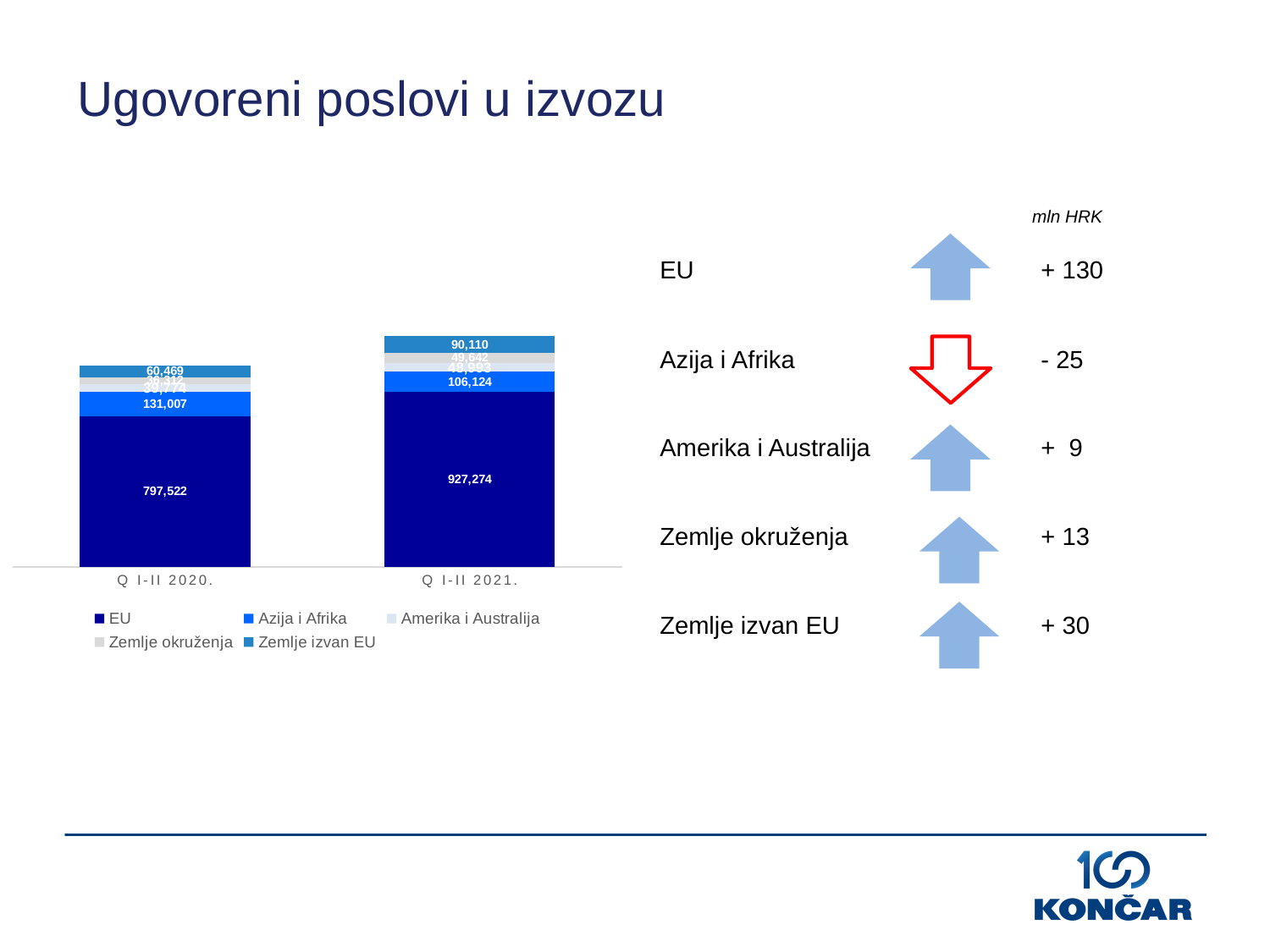
By how much did the EU segment increase from Q I-II 2020. to Q I-II 2021.? 129,752 What is the value of the EU segment for Q I-II 2021.? 927,274 What is the value of the Azija i Afrika segment for Q I-II 2020.? 131,007 What kind of chart is shown on the slide? Stacked bar chart What is the value of the EU segment for Q I-II 2020.? 797,522 How many series does the chart legend list? 5 What is the title of the slide containing the chart? Ugovoreni poslovi u izvozu Which period has the larger Azija i Afrika value, Q I-II 2020. or Q I-II 2021.? Q I-II 2020. What is the value of the Zemlje izvan EU segment (top of the bar) for Q I-II 2021.? 90,110 What is the value of the Azija i Afrika segment for Q I-II 2021.? 106,124 How many periods (categories) are shown on the x axis of the chart? 2 What is the value of the Zemlje izvan EU segment (top of the bar) for Q I-II 2020.? 60,469